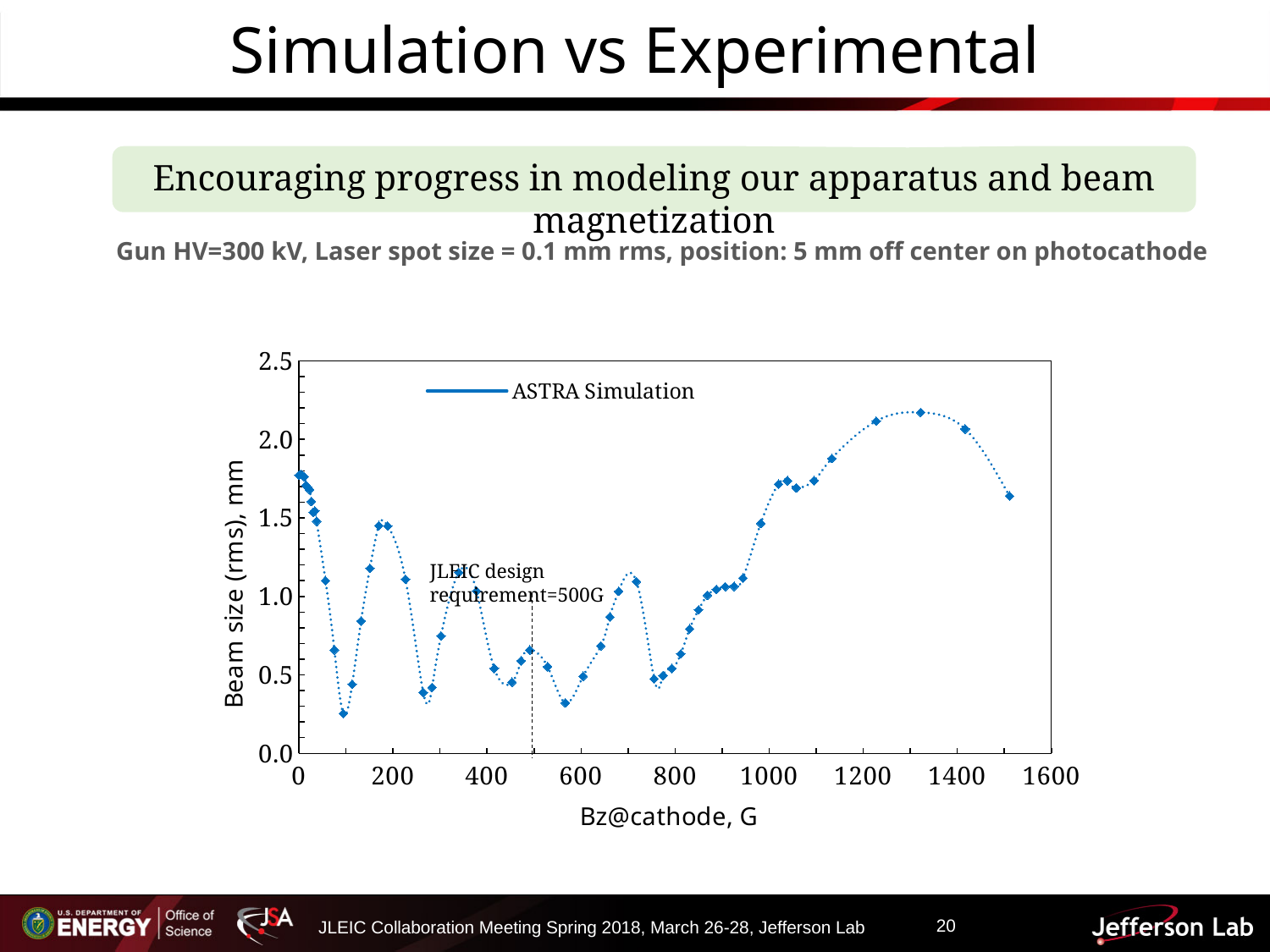
What is the name of the series shown in the legend? ASTRA Simulation What is the title of the x axis? Bz@cathode, G How many series does the legend list? 1 Does the beam size rise or fall as Bz@cathode increases from 1000 G to 1300 G? Rise Is the beam size at Bz@cathode of 0 G greater or less than 1.5 mm? greater Which is larger: the beam size at about 1300 G or the beam size at about 100 G? About 1300 G Is the beam size at Bz@cathode of about 100 G greater or less than 0.5 mm? less Is the beam size at Bz@cathode of about 1500 G greater or less than 2.0 mm? less What kind of chart is shown on the slide? Line chart with markers